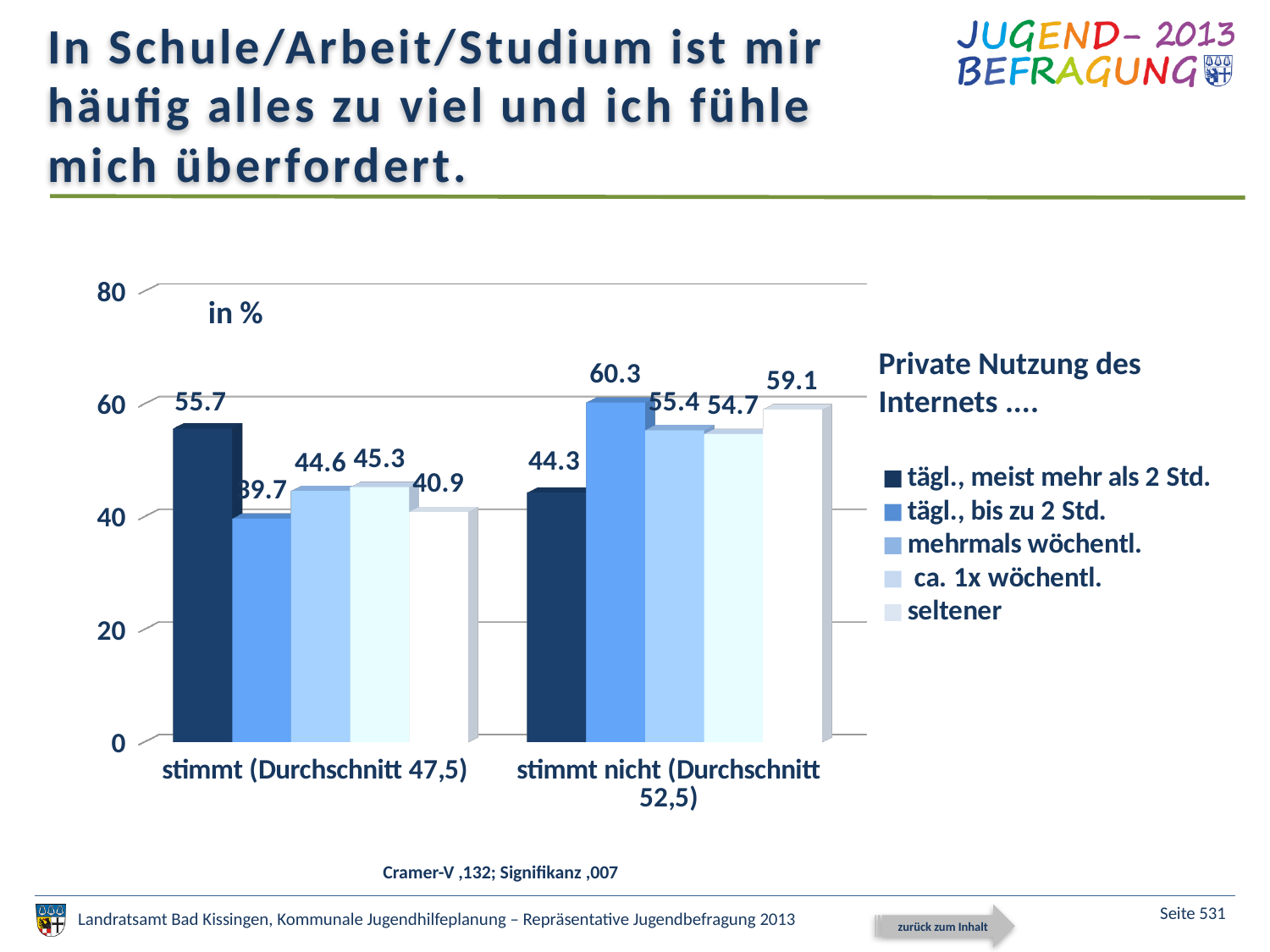
What kind of chart is shown on the slide? bar chart What is the value for "tägl., meist mehr als 2 Std." in the "stimmt (Durchschnitt 47,5)" category? 55.7 What is the value for "seltener" in the "stimmt (Durchschnitt 47,5)" category? 40.9 Is the value for "ca. 1x wöchentl." in the "stimmt nicht" category greater or less than 40? greater What is the difference between the "tägl., bis zu 2 Std." values for "stimmt nicht" and "stimmt"? 20.6 What is the value for "tägl., bis zu 2 Std." in the "stimmt nicht (Durchschnitt 52,5)" category? 60.3 What is the value for "mehrmals wöchentl." in the "stimmt nicht (Durchschnitt 52,5)" category? 55.4 Which series has the highest value in the "stimmt nicht (Durchschnitt 52,5)" category? tägl., bis zu 2 Std. How many series does the legend list? 5 Which series has the lowest value in the "stimmt (Durchschnitt 47,5)" category? tägl., bis zu 2 Std. Which is larger: the "tägl., meist mehr als 2 Std." value for "stimmt" or for "stimmt nicht"? stimmt How many categories are shown on the x axis? 2